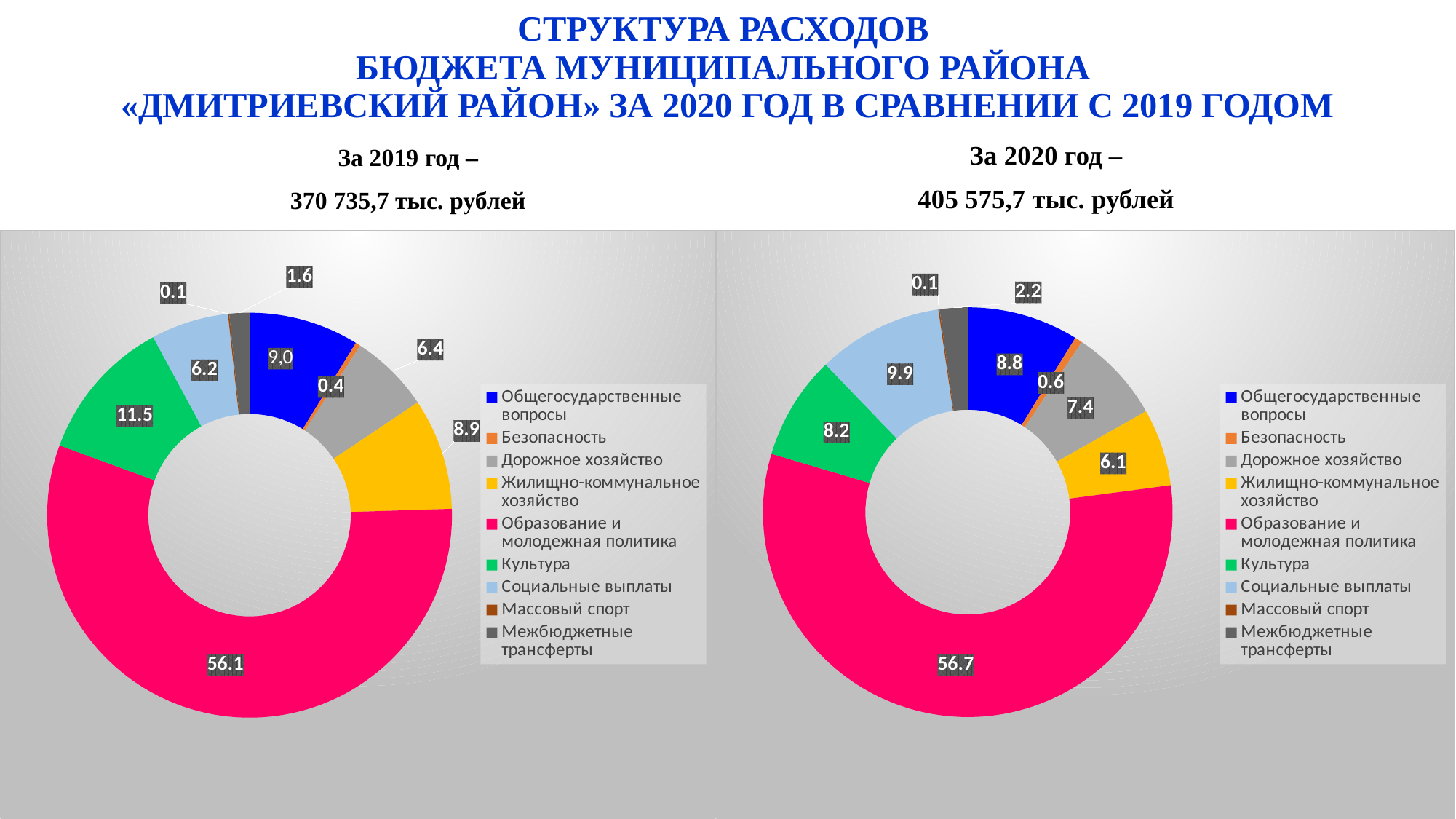
What kind of chart is used on this slide? Pie (donut) chart What is the difference between the value for Образование и молодежная политика in the right chart (2020) and in the left chart (2019)? 0.6 What total expenditure amount is shown above the right chart for 2020? 405 575,7 тыс. рублей In the left chart (За 2019 год), what is the value for Культура? 11.5 How many entries does the legend of the left chart (За 2019 год) list? 9 In the right chart (За 2020 год), what is the value for Социальные выплаты? 9.9 In the left chart (За 2019 год), what is the value for Образование и молодежная политика? 56.1 In the right chart (За 2020 год), what is the value for Дорожное хозяйство? 7.4 In the left chart (За 2019 год), which category has the smallest share? Массовый спорт In the right chart (За 2020 год), what is the difference between Социальные выплаты and Культура? 1.7 In the right chart (За 2020 год), which category has the largest share? Образование и молодежная политика In the left chart (За 2019 год), which is larger: Жилищно-коммунальное хозяйство or Дорожное хозяйство? Жилищно-коммунальное хозяйство